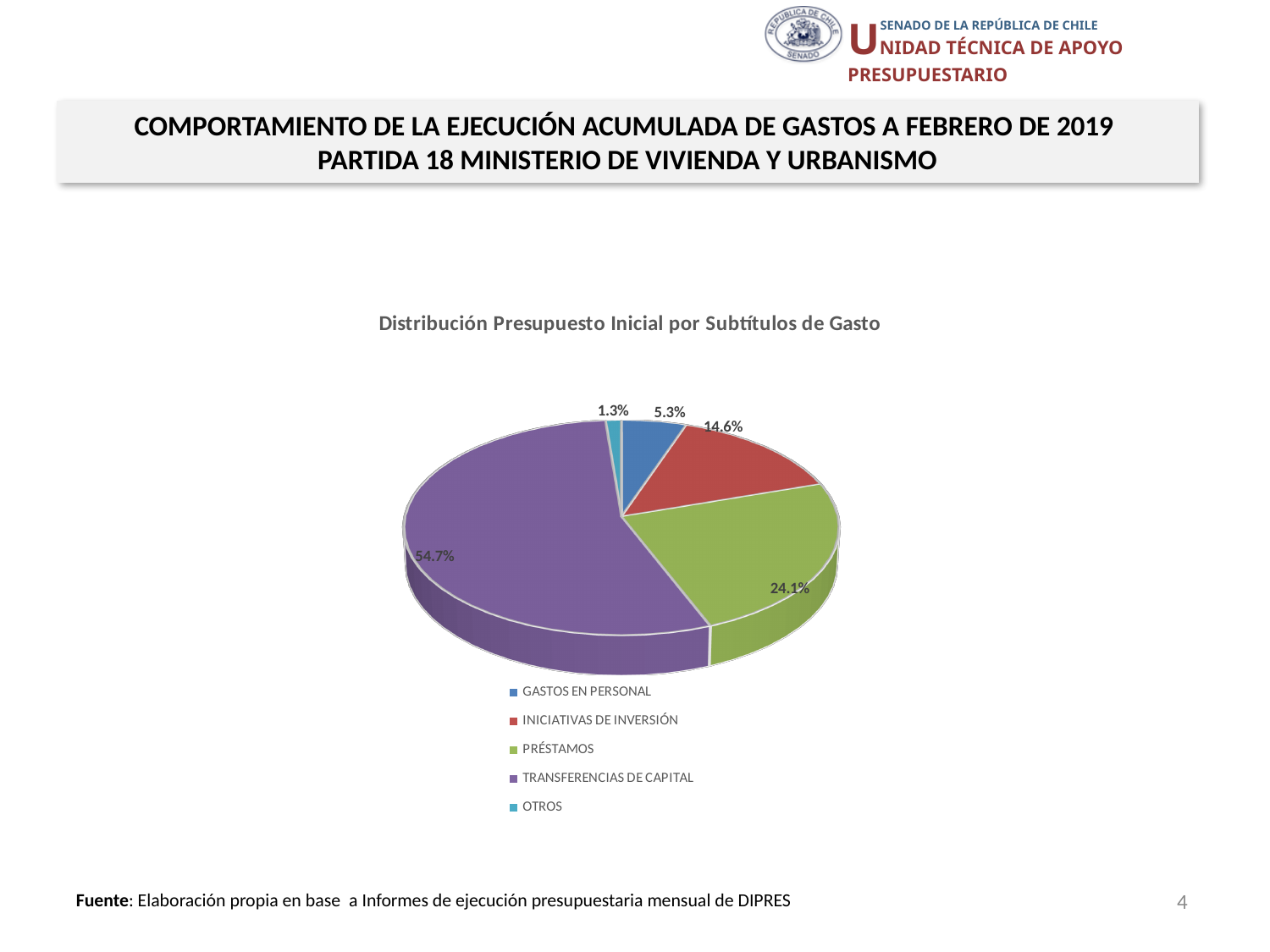
What is the difference in percentage points between TRANSFERENCIAS DE CAPITAL and PRÉSTAMOS? 30.6 Which category has the largest share of the pie? TRANSFERENCIAS DE CAPITAL What share of the pie does OTROS represent? 1.3% What share of the pie does GASTOS EN PERSONAL represent? 5.3% What kind of chart is shown on the slide? Pie chart Which is larger, the share for INICIATIVAS DE INVERSIÓN or the share for GASTOS EN PERSONAL? INICIATIVAS DE INVERSIÓN What share of the pie does PRÉSTAMOS represent? 24.1% How many categories does the legend list? 5 Which category has the smallest share of the pie? OTROS What is the title of the chart? Distribución Presupuesto Inicial por Subtítulos de Gasto